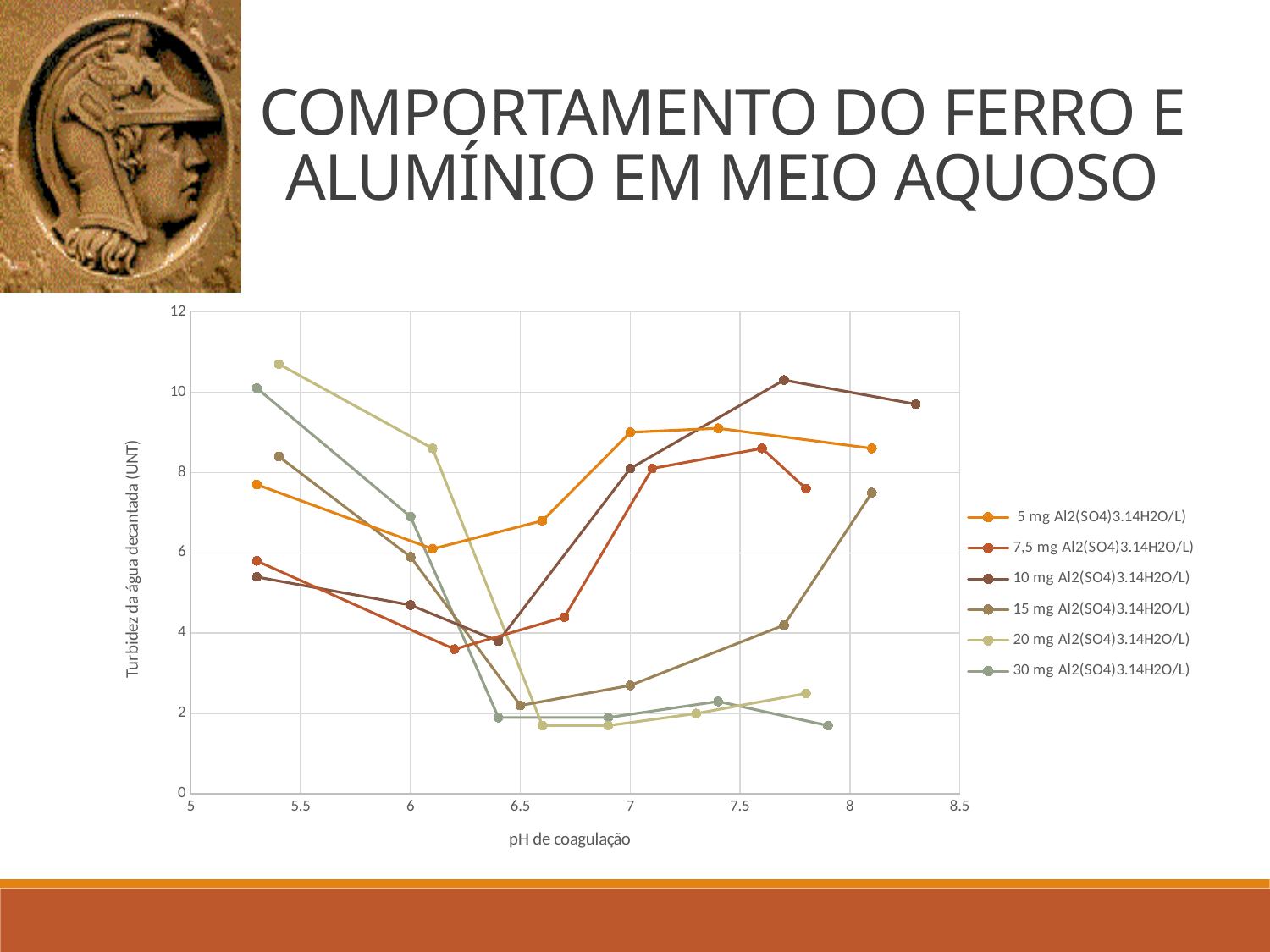
Does the 15 mg Al2(SO4)3.14H2O/L series rise or fall between pH 6.5 and pH 8.1? rise Is the value for the 5 mg Al2(SO4)3.14H2O/L series at pH 7 greater or less than 8? greater Is the value for the 15 mg Al2(SO4)3.14H2O/L series at pH 8.1 greater or less than 8? less Is the value for the 7,5 mg Al2(SO4)3.14H2O/L series at pH 6.2 greater or less than 4? less What is the label of the y axis? Turbidez da água decantada (UNT) What kind of chart is shown on the slide? line chart What is the label of the x axis? pH de coagulação Does the 20 mg Al2(SO4)3.14H2O/L series rise or fall between pH 5.4 and pH 6.6? fall How many series does the legend list? 6 At pH 6, which series has the larger value: 30 mg Al2(SO4)3.14H2O/L or 15 mg Al2(SO4)3.14H2O/L? 30 mg Al2(SO4)3.14H2O/L